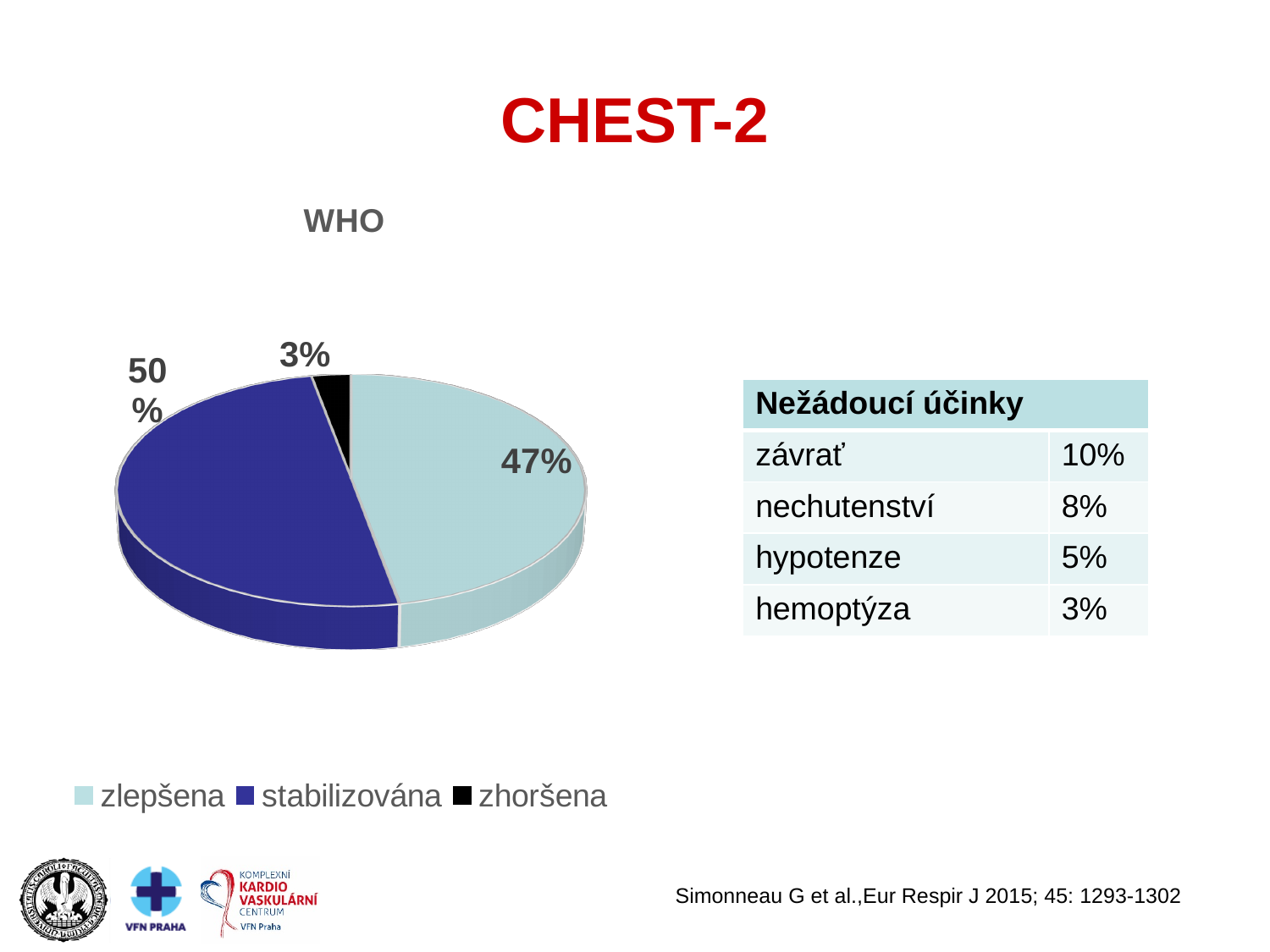
What share of the pie does the 'zlepšena' slice represent? 47% How many slices does the pie chart have? 3 What share of the pie does the 'zhoršena' slice represent? 3% What is the difference between the 'stabilizována' and 'zhoršena' shares? 47% What is the chart's title? WHO Which category has the smallest slice of the pie? zhoršena What kind of chart is shown on the slide? pie chart Which category has the largest slice of the pie? stabilizována How many entries does the legend list? 3 What share of the pie does the 'stabilizována' slice represent? 50% Which is larger, the 'zlepšena' slice or the 'zhoršena' slice? zlepšena What colour is the 'zhoršena' slice? black